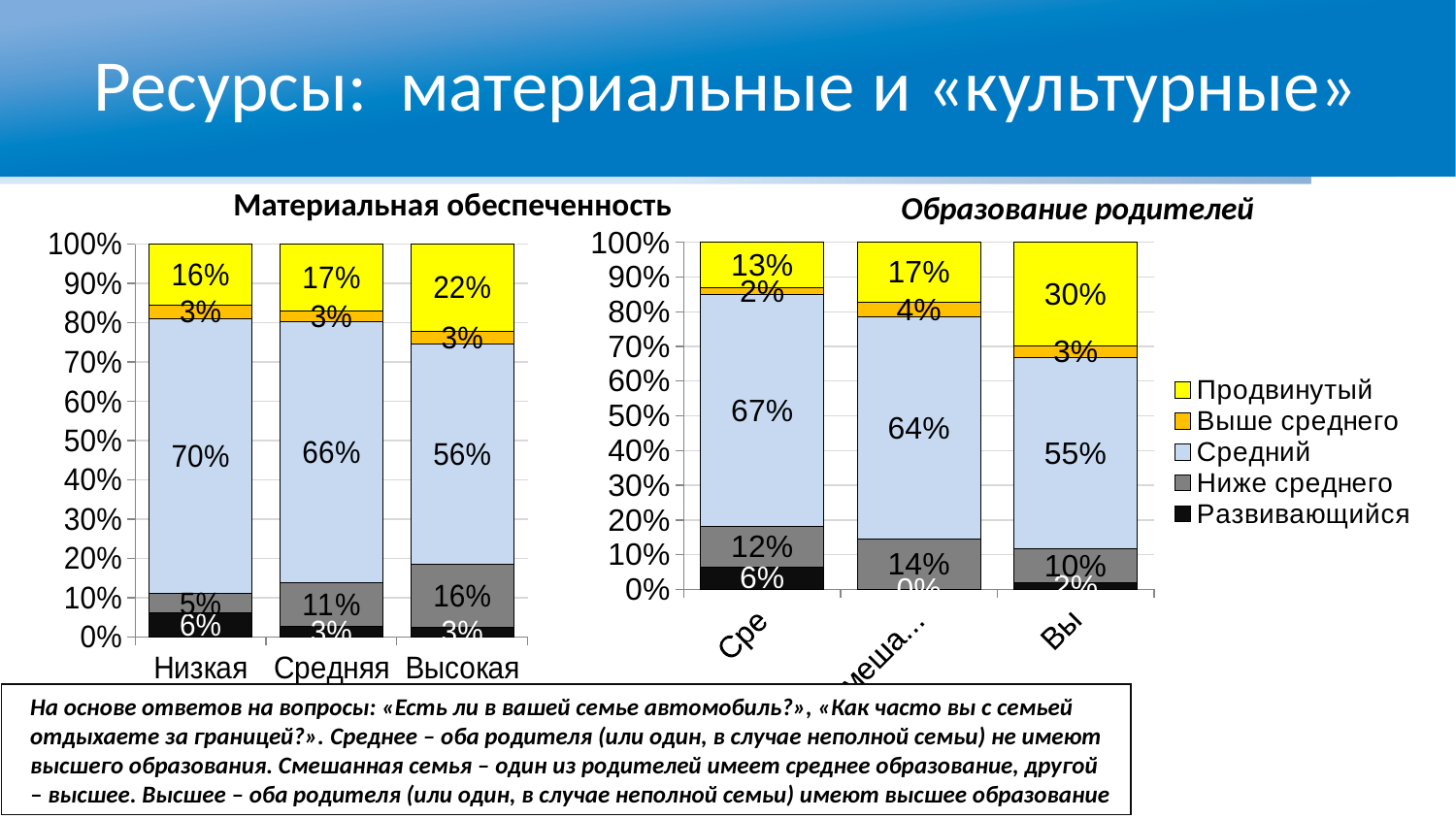
In the 'Материальная обеспеченность' chart, what is the value of the 'Продвинутый' segment for 'Высокая'? 22% In the 'Материальная обеспеченность' chart, what is the value of the 'Средний' segment for 'Низкая'? 70% How many series does the legend on the slide list? 5 In the 'Материальная обеспеченность' chart, what is the value of the 'Ниже среднего' segment for 'Высокая'? 16% In the 'Материальная обеспеченность' chart, does the 'Продвинутый' segment rise or fall from 'Низкая' to 'Высокая'? rises In the 'Материальная обеспеченность' chart, which category has the largest 'Продвинутый' segment? Высокая In the 'Образование родителей' chart, what is the value of the 'Продвинутый' segment in the third (rightmost) bar? 30% In the 'Материальная обеспеченность' chart, what is the difference between the 'Средний' segment for 'Низкая' and for 'Высокая'? 14 percentage points What kind of chart is the 'Образование родителей' chart? stacked bar chart In the 'Образование родителей' chart, is the 'Ниже среднего' segment larger in the first bar or the second bar? the second bar In the 'Образование родителей' chart, what is the value of the 'Средний' segment in the first (leftmost) bar? 67% How many categories are shown on the x axis of the 'Материальная обеспеченность' chart? 3